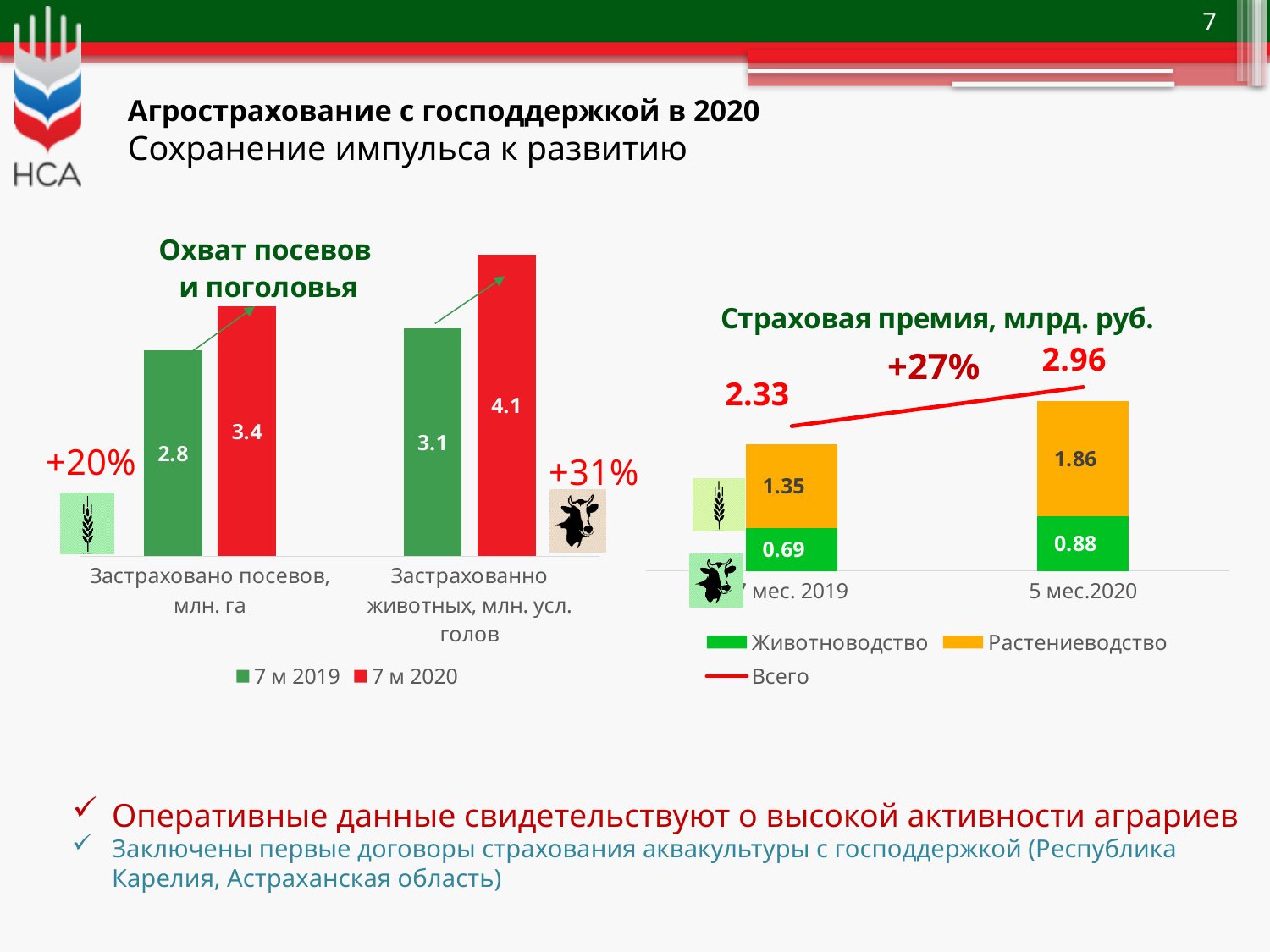
In the chart 'Охват посевов и поголовья', which series has the larger value for 'Застраховано посевов, млн. га'? 7 м 2020 How many entries does the legend of the chart 'Страховая премия, млрд. руб.' list? 3 What kind of chart is 'Охват посевов и поголовья'? Bar chart In the chart 'Страховая премия, млрд. руб.', what percentage growth is shown between the two periods? +27% How many series does the legend of the chart 'Охват посевов и поголовья' list? 2 In the chart 'Охват посевов и поголовья', what is the value for 'Застраховано посевов, млн. га' in the '7 м 2020' series? 3.4 In the chart 'Страховая премия, млрд. руб.', what is the 'Животноводство' value for '5 мес.2020'? 0.88 In the chart 'Охват посевов и поголовья', what is the value for 'Застрахованно животных, млн. усл. голов' in the '7 м 2019' series? 3.1 In the chart 'Страховая премия, млрд. руб.', what is the total ('Всего') for '5 мес.2020'? 2.96 In the chart 'Охват посевов и поголовья', what is the difference between the '7 м 2020' and '7 м 2019' values for 'Застрахованно животных, млн. усл. голов'? 1.0 In the chart 'Страховая премия, млрд. руб.', what is the 'Растениеводство' value for '5 мес.2020'? 1.86 In the chart 'Страховая премия, млрд. руб.', what is the difference between the 'Растениеводство' values for '5 мес.2020' and the 2019 period? 0.51